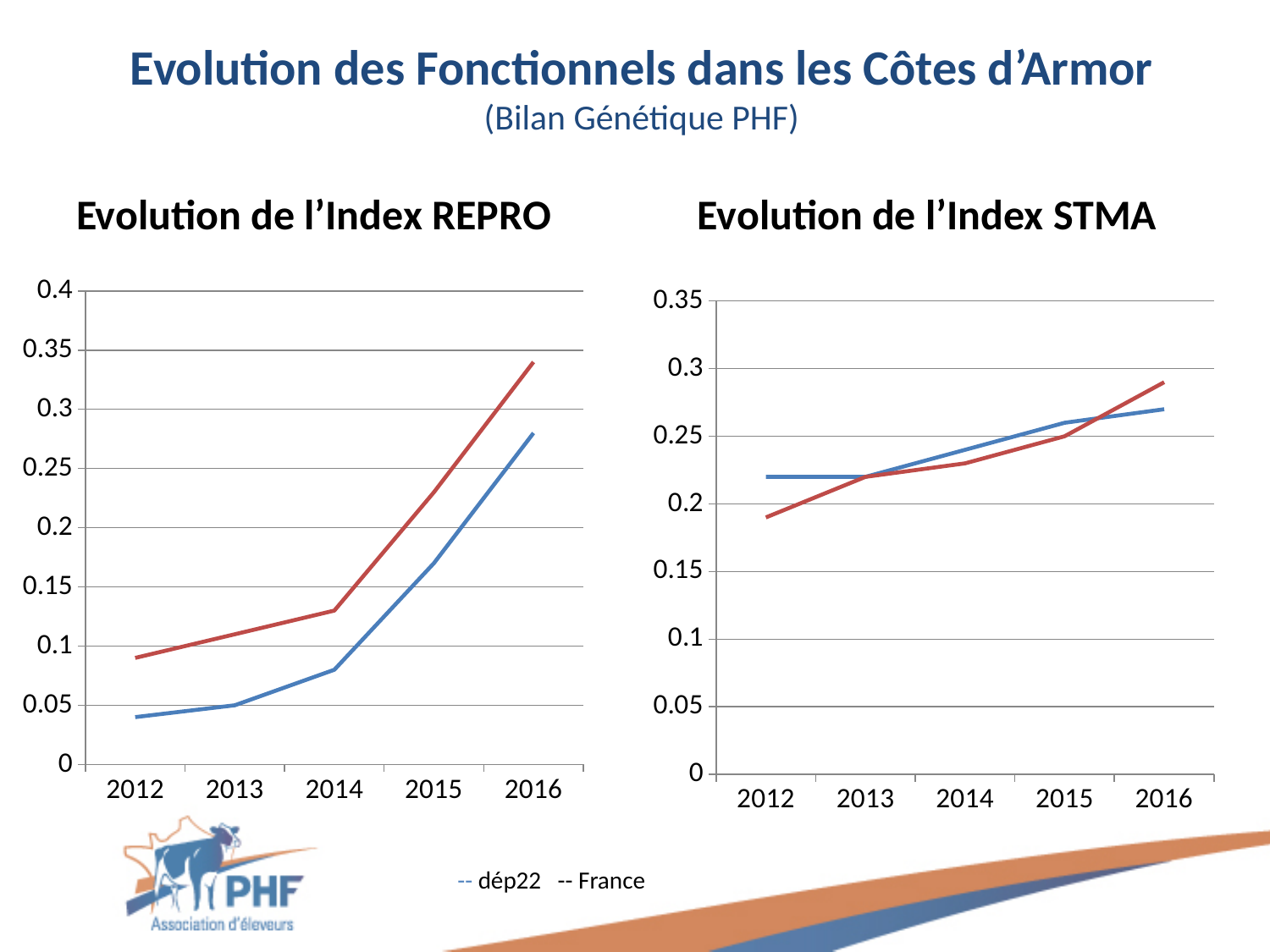
In the 'Evolution de l'Index REPRO' chart, is the dép22 value for 2015 greater or less than 0.15? greater In the 'Evolution de l'Index REPRO' chart, do the values rise or fall from 2012 to 2016? rise In the 'Evolution de l'Index STMA' chart, do the dép22 values rise or fall from 2012 to 2016? rise In the 'Evolution de l'Index REPRO' chart, is the dép22 value for 2012 greater or less than 0.05? less In the 'Evolution de l'Index REPRO' chart, which series has the higher value in 2016, dép22 or France? France In the 'Evolution de l'Index REPRO' chart, is the France value for 2016 greater or less than 0.3? greater What kind of chart is the 'Evolution de l'Index REPRO' chart? line chart How many series does the legend list for the charts? 2 In the 'Evolution de l'Index STMA' chart, which series has the higher value in 2016, dép22 or France? France What colour is the dép22 line in the charts? blue How many years are shown on the x axis of the 'Evolution de l'Index STMA' chart? 5